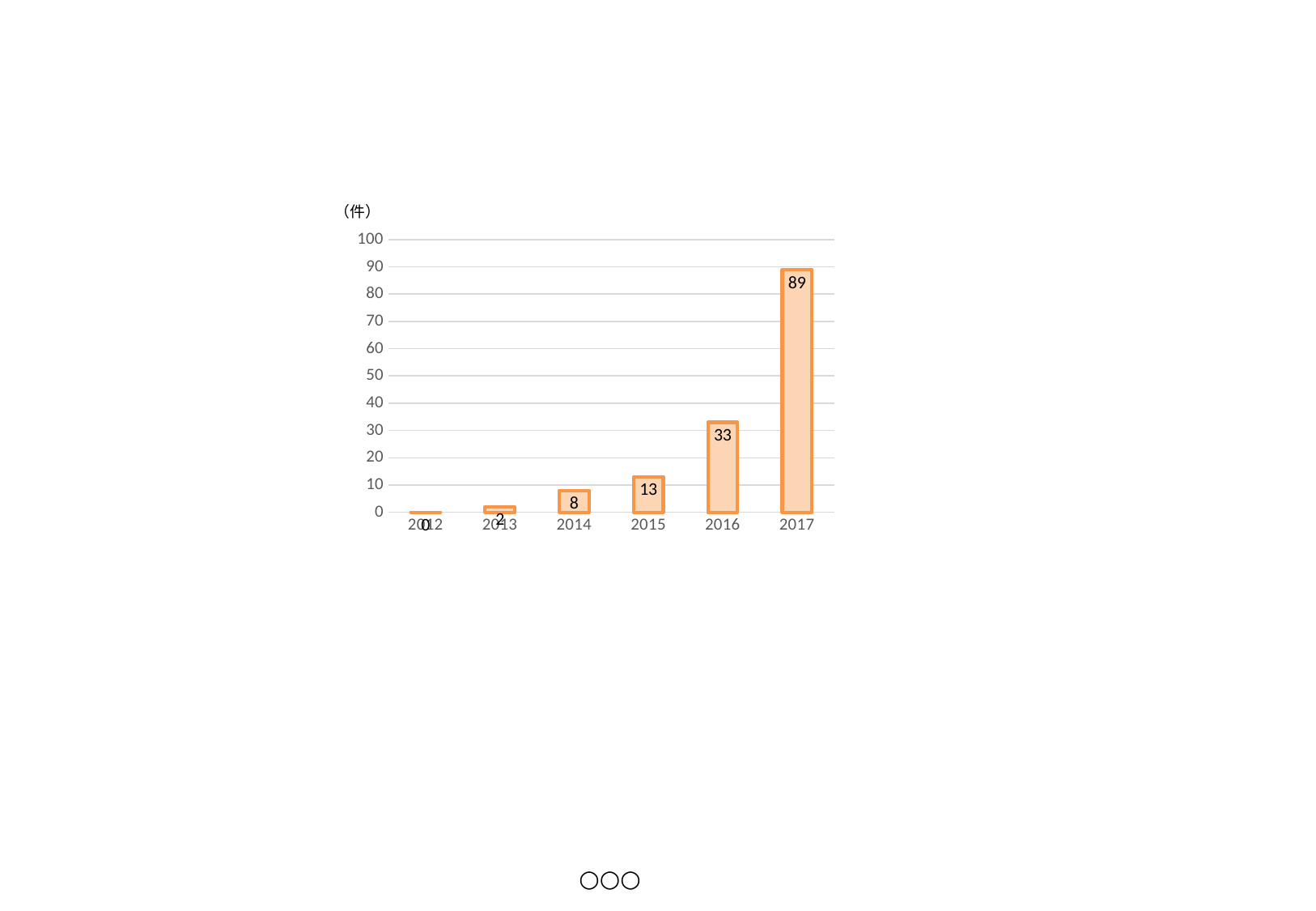
How many years are shown on the x axis? 6 What is the value for 2015? 13 What is the difference between the values for 2017 and 2016? 56 Do the values rise or fall from 2012 to 2017? rise Is the value for 2016 greater or less than 40? less Which year has the lowest value? 2012 What is the value for 2014? 8 What is the value for 2017? 89 What is the value for 2016? 33 What type of chart is shown on the slide? bar chart Which year has the highest value? 2017 Which is larger, the value for 2015 or the value for 2014? 2015